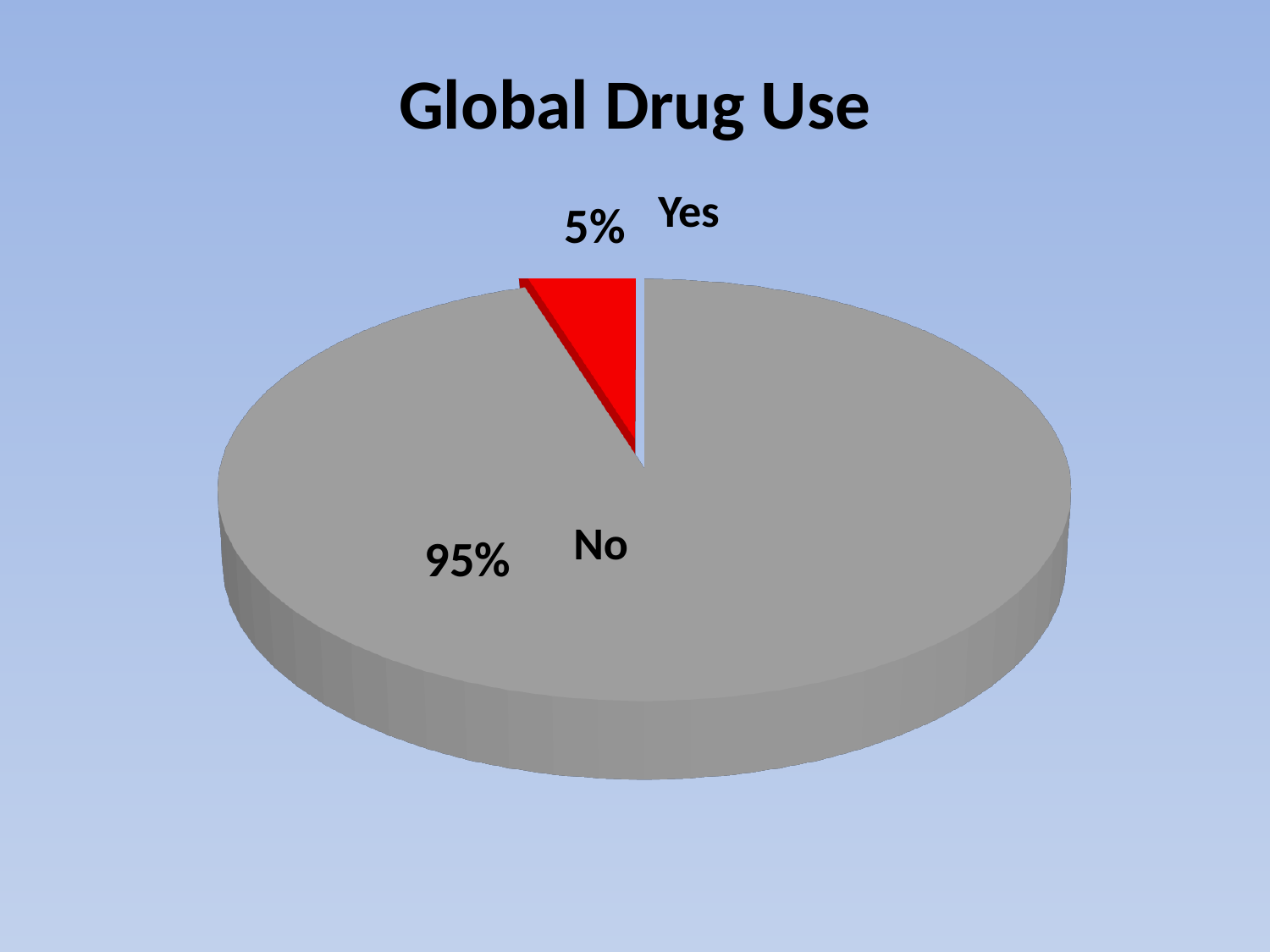
Which slice is the largest? No What is the title of the chart? Global Drug Use Which slice is larger, "Yes" or "No"? No What colour is the "Yes" slice? Red What share of the pie does the "Yes" slice represent? 5% What is the difference in percentage points between the "No" slice and the "Yes" slice? 90 What kind of chart is shown on the slide? Pie chart Which slice is the smallest? Yes How many slices does the pie chart have? 2 What percentage of the pie is labelled "Yes"? 5% What percentage of the pie is labelled "No"? 95%